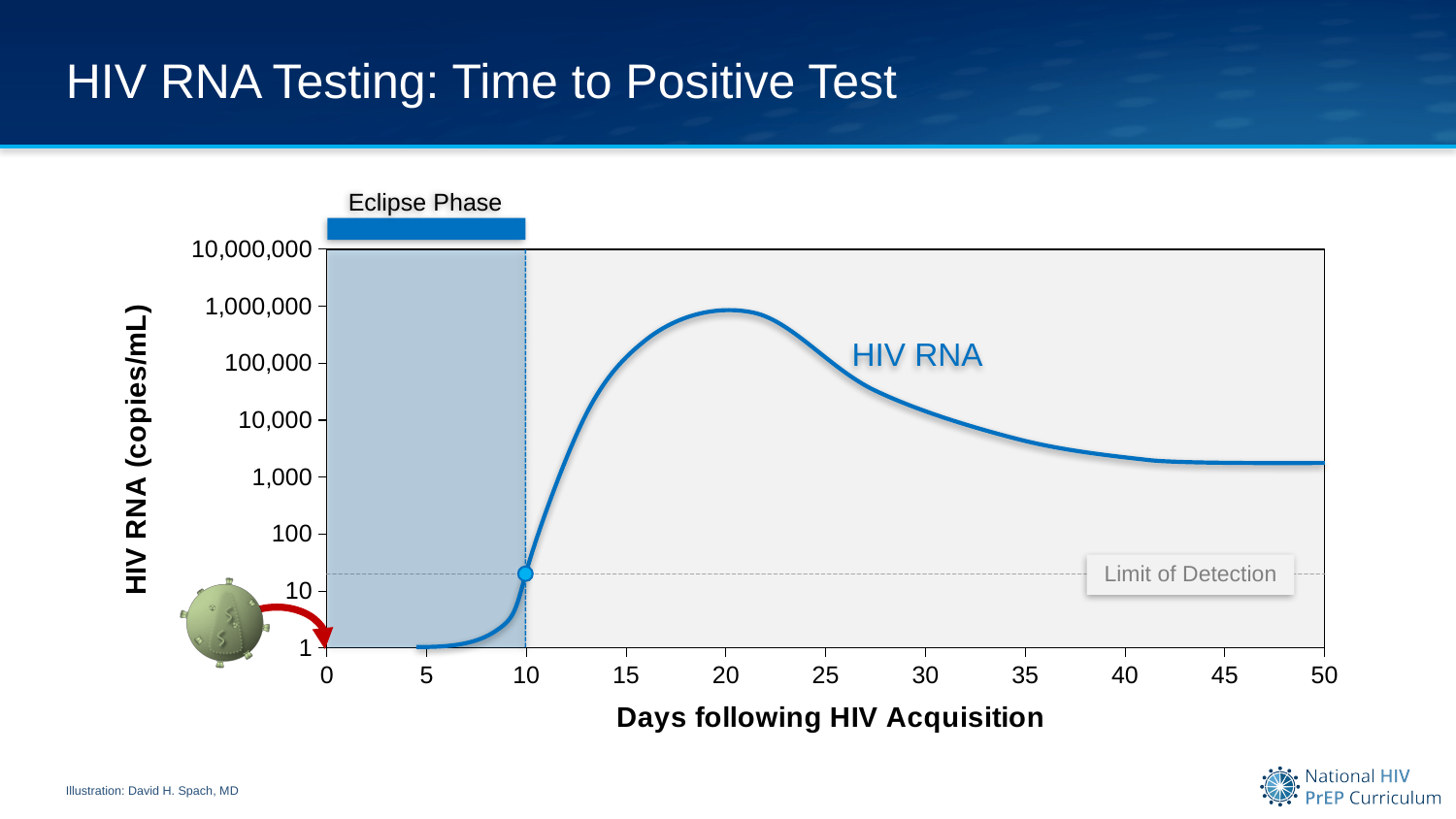
Does the HIV RNA curve rise or fall between day 25 and day 40? fall Is the HIV RNA value higher at day 20 or at day 40? day 20 On which day does the HIV RNA curve cross the Limit of Detection line? 10 What kind of chart is shown on the slide? line chart On which day does the shaded Eclipse Phase end? 10 What is the label of the x axis? Days following HIV Acquisition Does the HIV RNA curve rise or fall between day 10 and day 20? rise Is the HIV RNA value at day 45 greater or less than 10,000 copies/mL? less What is the title of the slide's chart? HIV RNA Testing: Time to Positive Test Is the HIV RNA value at day 5 greater or less than 10 copies/mL? less What is the highest value shown on the y axis? 10,000,000 Is the HIV RNA value at day 20 greater or less than 100,000 copies/mL? greater